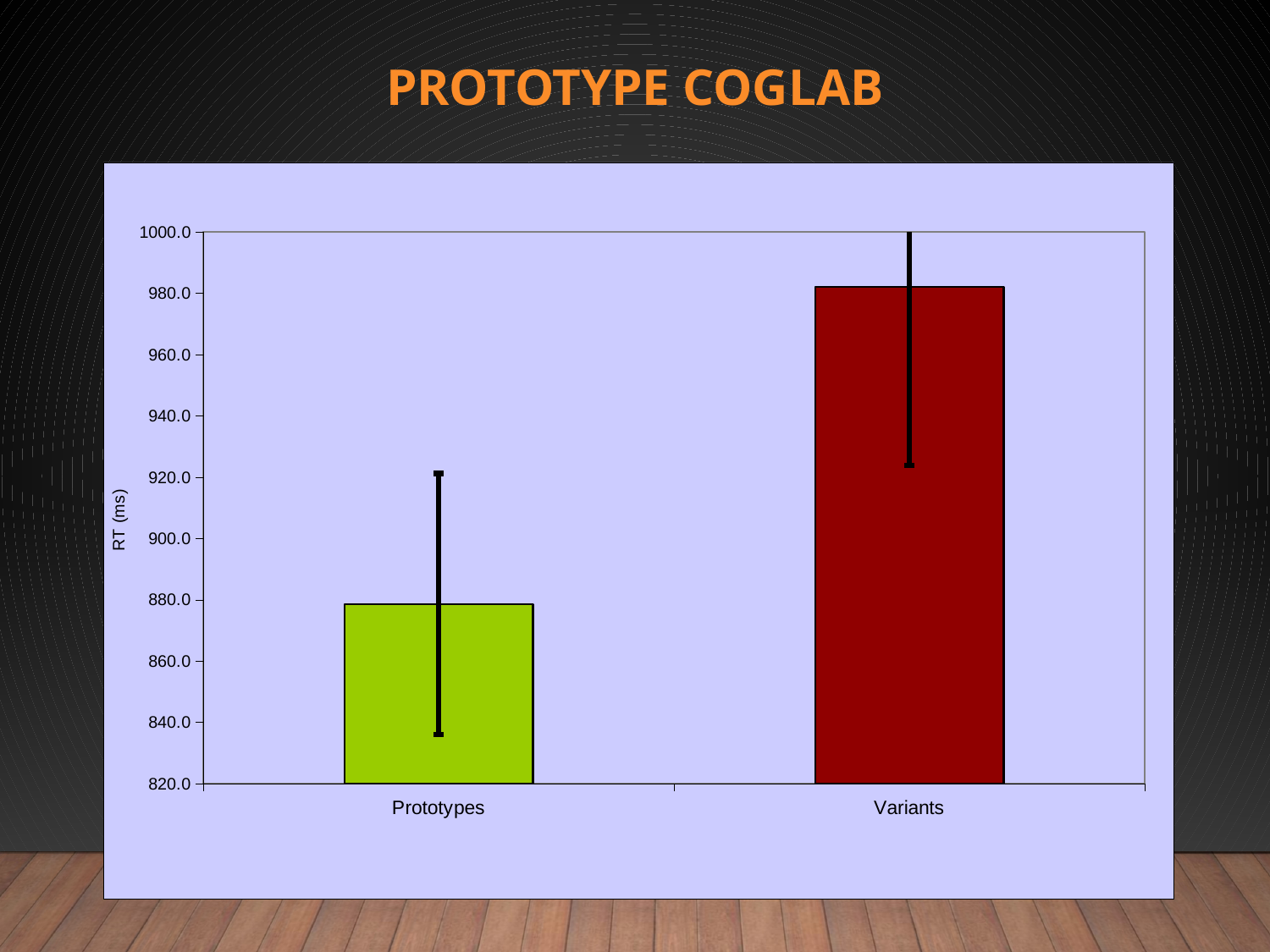
Is the value for Variants greater or less than 960? greater Which is larger, the RT for Prototypes or the RT for Variants? Variants Is the value for Prototypes greater or less than 900? less What is the title of the slide? PROTOTYPE COGLAB What is the label on the y axis? RT (ms) Which category has the lowest RT (ms)? Prototypes Is the value for Variants greater or less than 1000? less How many categories are plotted on the x axis? 2 What kind of chart is shown on the slide? bar chart Which category has the highest RT (ms)? Variants